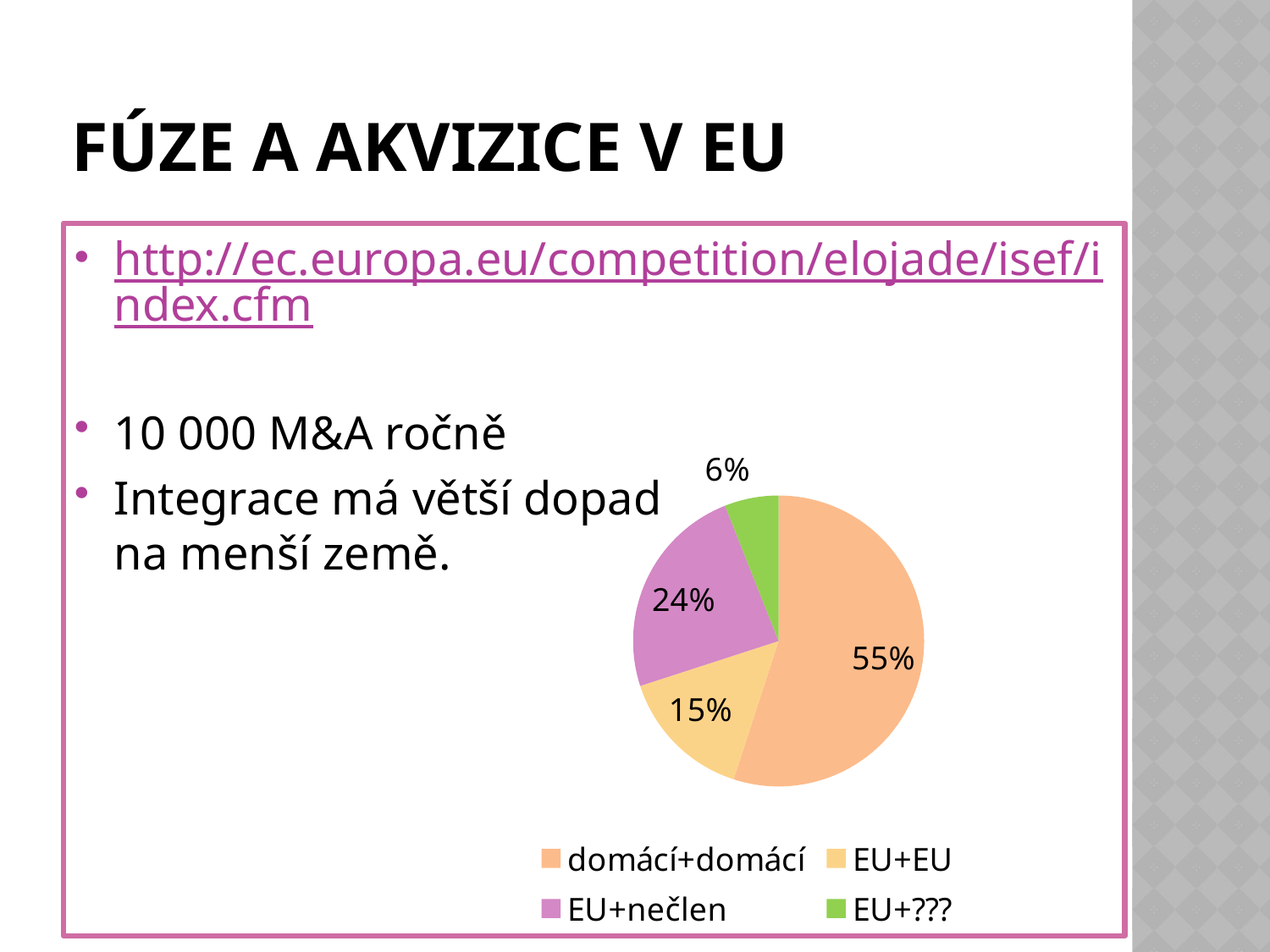
How many entries does the legend list? 4 What share of the pie does EU+EU have? 15% What kind of chart is shown on the slide? pie chart Which is larger, the share for EU+EU or the share for EU+nečlen? EU+nečlen What share of the pie does EU+nečlen have? 24% How many slices does the pie chart have? 4 What colour is the slice for EU+??? green What is the difference in percentage points between domácí+domácí and EU+nečlen? 31 Which category has the largest slice of the pie? domácí+domácí What share of the pie does EU+??? have? 6% Which category has the smallest slice of the pie? EU+???